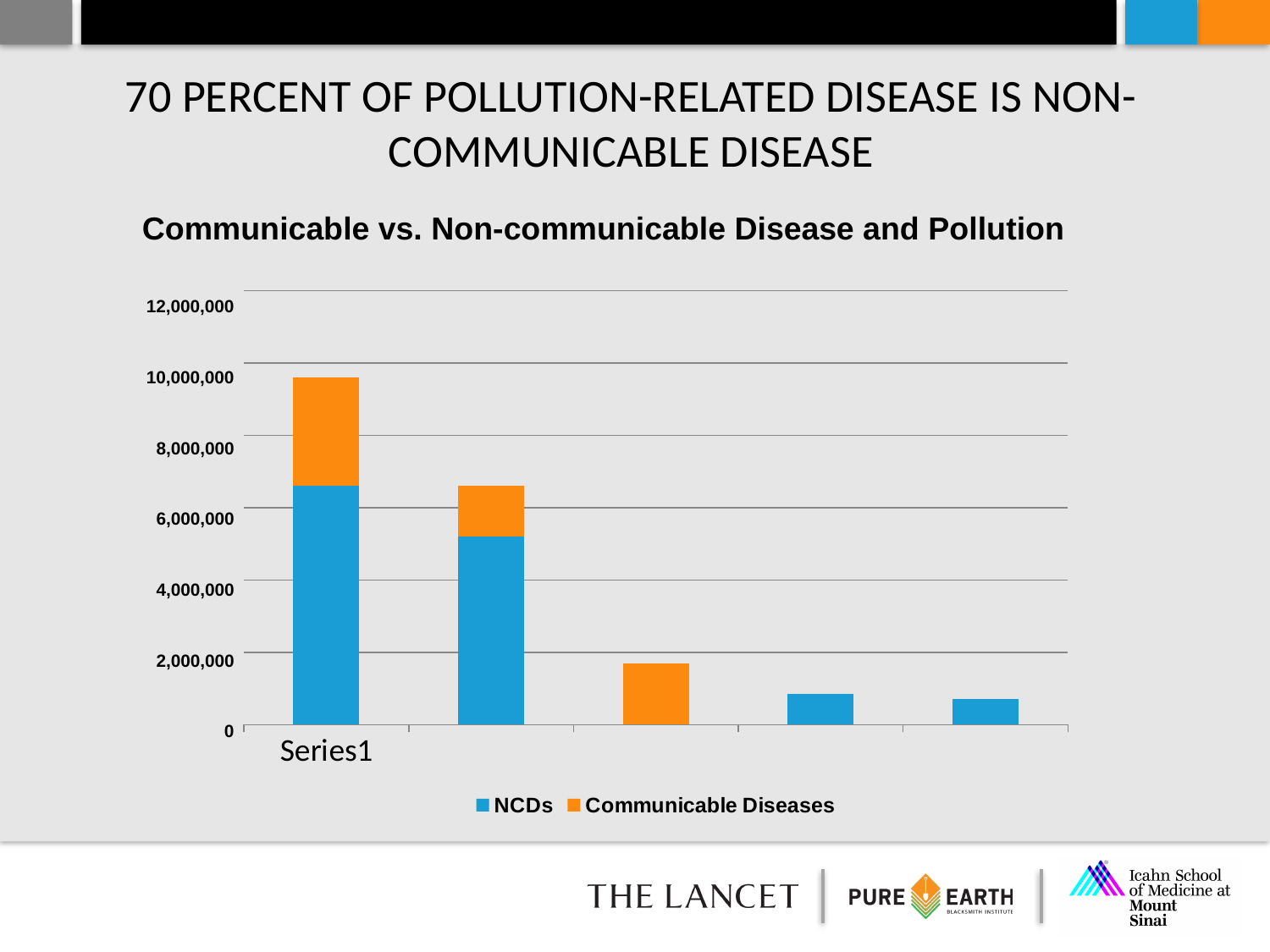
What is the highest value shown on the y axis? 12,000,000 What kind of chart is shown on the slide? bar chart Is the total stacked value for Series1 greater or less than 8,000,000? greater How many series does the legend list? 2 How many bars are plotted in the chart? 5 Which bar has the highest total value? Series1 Is the NCDs value for Series1 greater or less than 6,000,000? greater Which colour represents NCDs in the chart? blue For Series1, which is larger: NCDs or Communicable Diseases? NCDs What is the title of the chart? Communicable vs. Non-communicable Disease and Pollution Is the NCDs value for Series1 greater or less than 8,000,000? less Do the stacked bar totals rise or fall from left to right along the x axis? fall